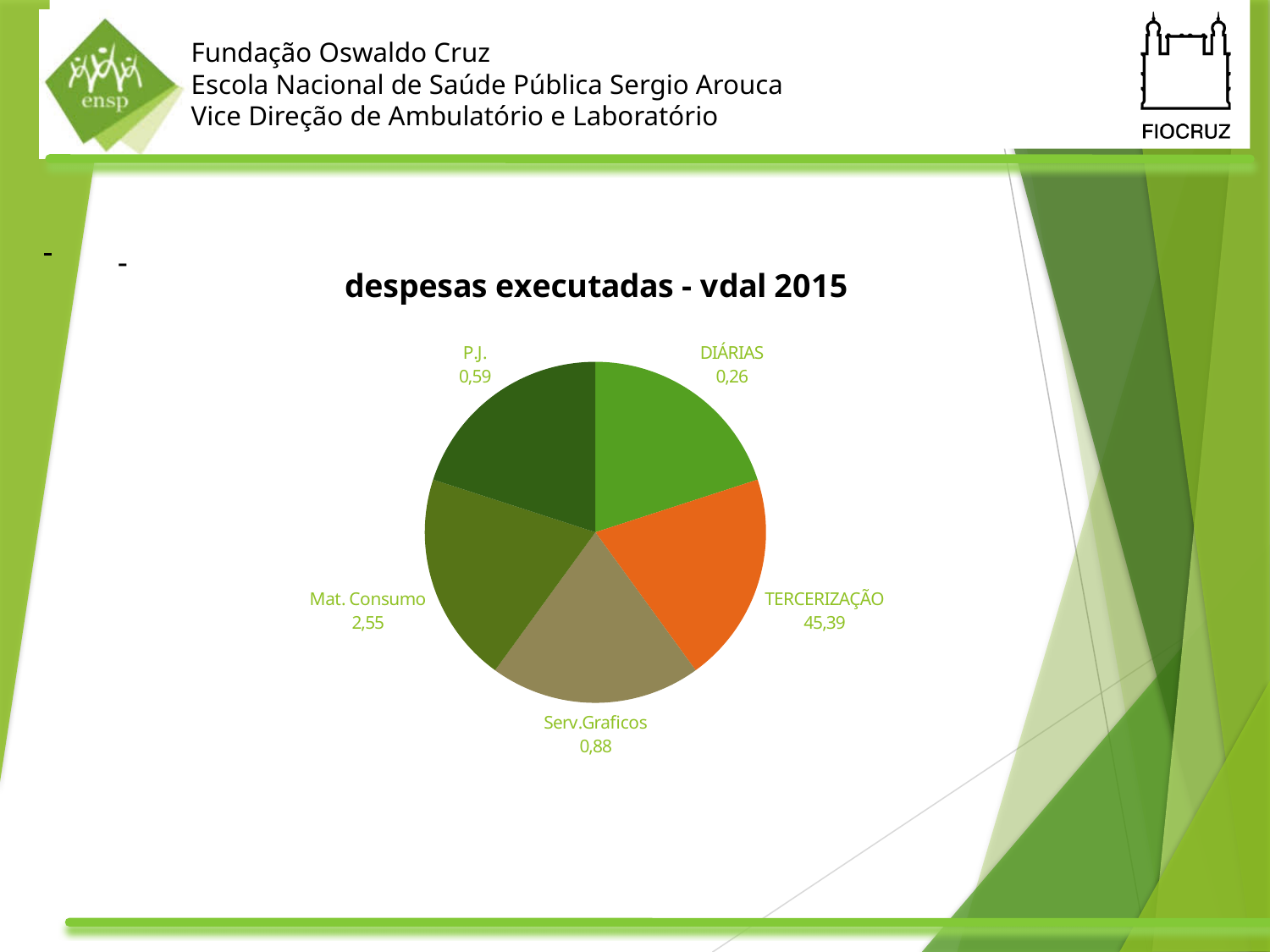
Which has the larger value, Mat. Consumo or Serv.Graficos? Mat. Consumo What is the value shown for Mat. Consumo? 2,55 What is the value shown for P.J.? 0,59 Which category has the highest labelled value? TERCERIZAÇÃO What type of chart is shown on the slide? Pie chart What is the value shown for Serv.Graficos? 0,88 How many categories does the pie chart show? 5 What is the value shown for DIÁRIAS? 0,26 What is the title of the chart? despesas executadas - vdal 2015 What is the difference between the values for TERCERIZAÇÃO and Mat. Consumo? 42,84 Which category has the lowest labelled value? DIÁRIAS What is the value shown for TERCERIZAÇÃO? 45,39